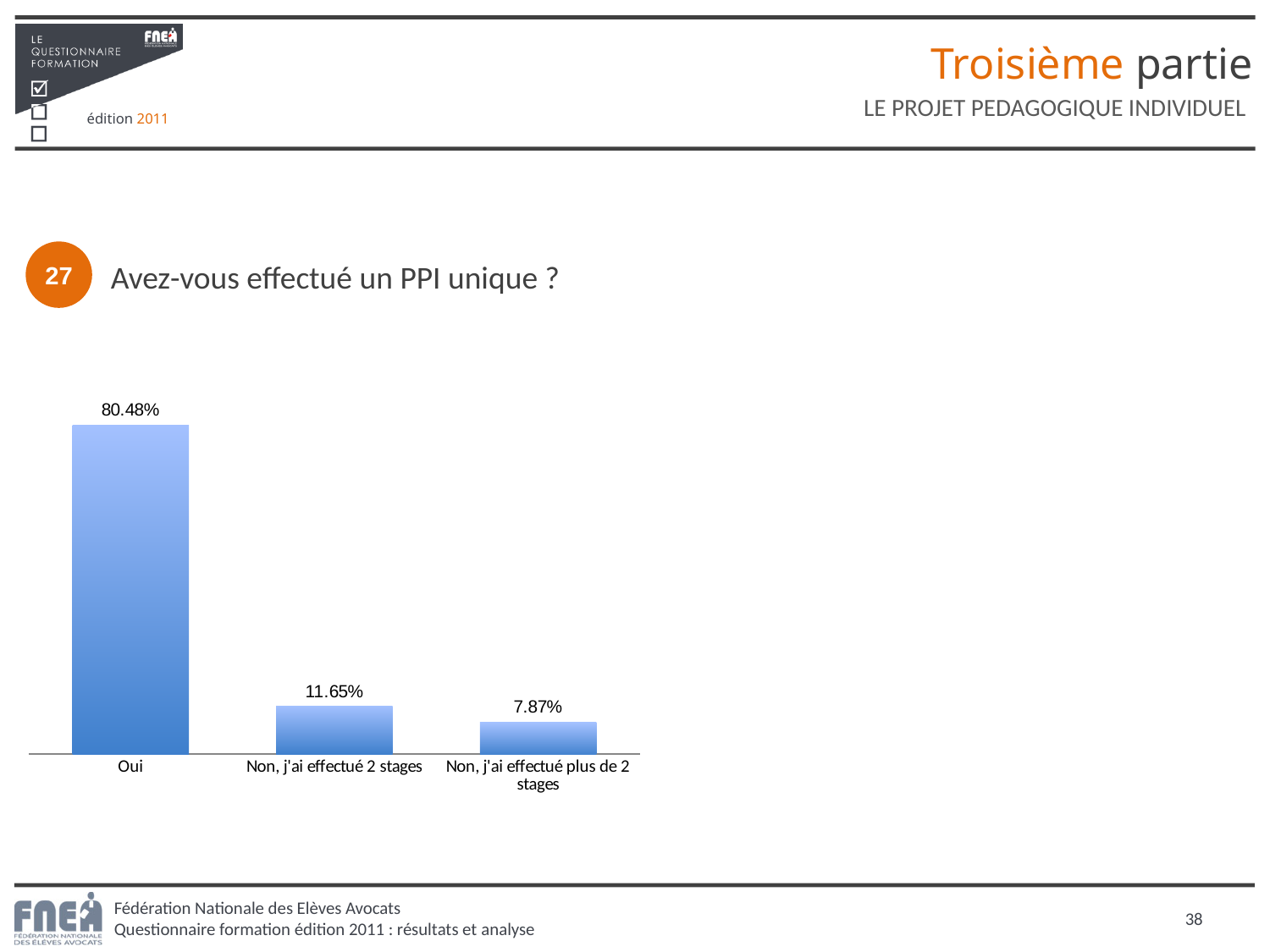
Which is larger, the value for "Non, j'ai effectué 2 stages" or for "Non, j'ai effectué plus de 2 stages"? Non, j'ai effectué 2 stages What question does the chart on the slide answer? Avez-vous effectué un PPI unique ? What is the difference between the values for "Oui" and "Non, j'ai effectué 2 stages"? 68.83% Which category has the highest value? Oui How many categories are shown in the chart? 3 What is the value for "Non, j'ai effectué plus de 2 stages"? 7.87% Which category has the lowest value? Non, j'ai effectué plus de 2 stages What is the value for "Non, j'ai effectué 2 stages"? 11.65% What kind of chart is shown on the slide? Bar chart Do the values rise or fall from left to right across the categories? Fall What is the difference between the values for "Non, j'ai effectué 2 stages" and "Non, j'ai effectué plus de 2 stages"? 3.78% What is the value for "Oui"? 80.48%